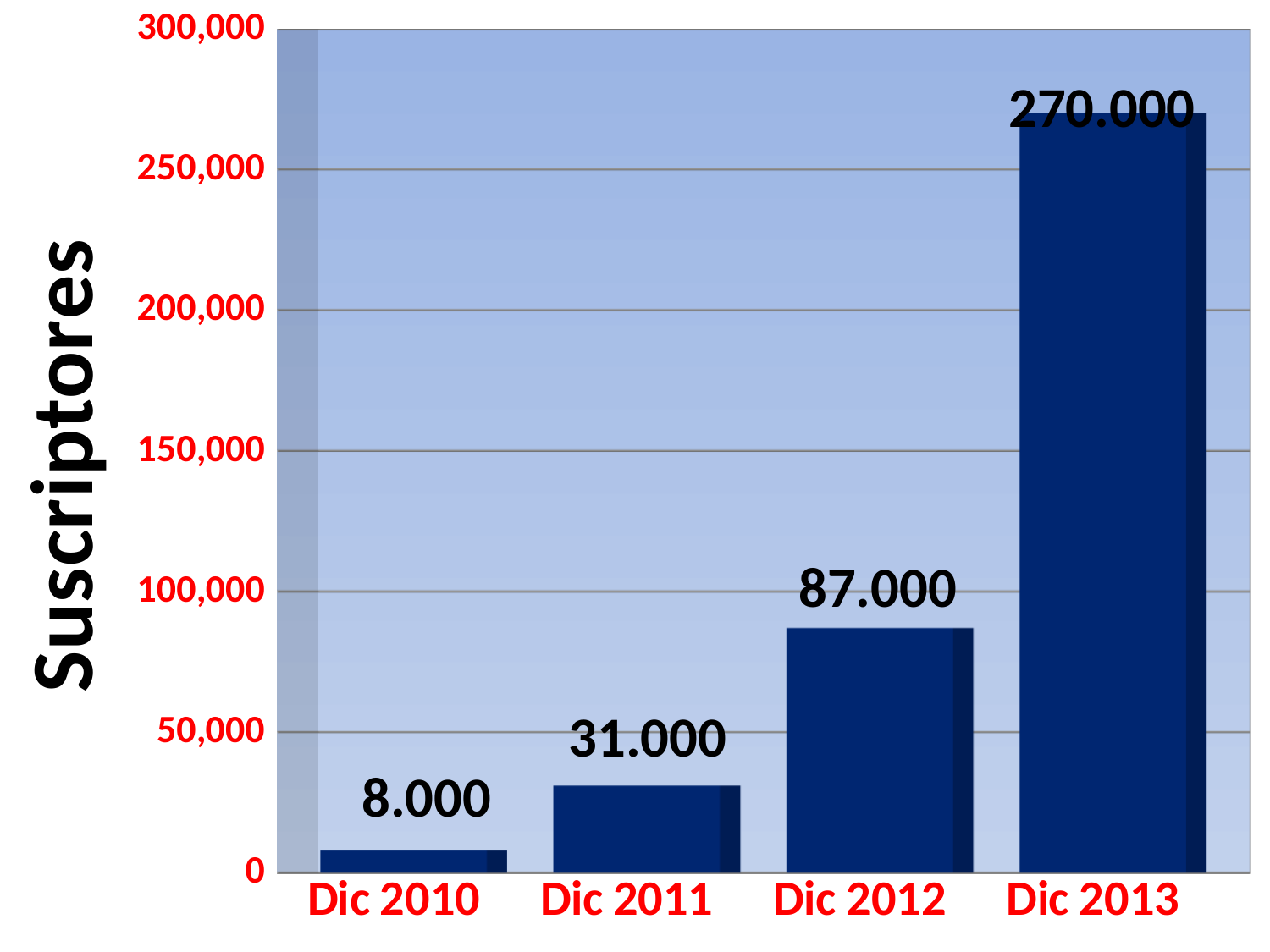
How many categories are shown on the x axis? 4 What is the value for Dic 2012? 87.000 What is the difference between the values for Dic 2011 and Dic 2010? 23.000 Which category has the lowest value? Dic 2010 What is the value for Dic 2011? 31.000 What is the difference between the values for Dic 2013 and Dic 2012? 183.000 What is the value for Dic 2010? 8.000 What is the value for Dic 2013? 270.000 Do the values rise or fall from Dic 2010 to Dic 2013? rise What kind of chart is this? bar chart Which category has the highest value? Dic 2013 Which is larger, the value for Dic 2012 or the value for Dic 2011? Dic 2012